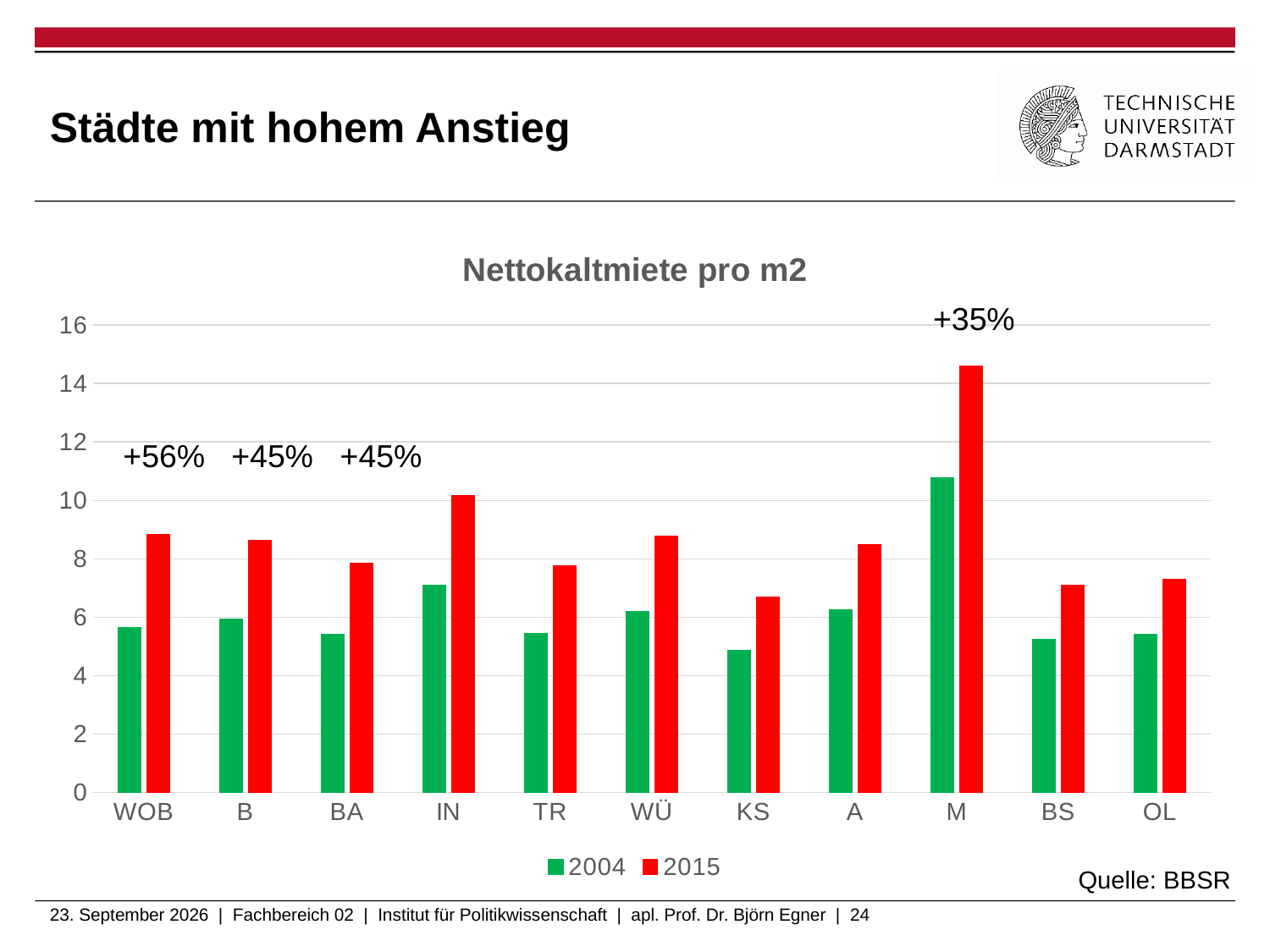
Which city has the lowest value for 2004? KS Is the 2015 value for M greater or less than 14? greater What kind of chart is shown on the slide? bar chart Is the 2004 value for KS greater or less than 6? less What percentage increase is annotated above the bars for M? +35% How many series does the legend list? 2 Which is larger, the 2015 value for IN or the 2015 value for WÜ? IN What is the title of the chart? Nettokaltmiete pro m2 Which city has the highest value for 2004? M Which city has the lowest value for 2015? KS How many cities are shown on the x axis? 11 Which city has the highest value for 2015? M